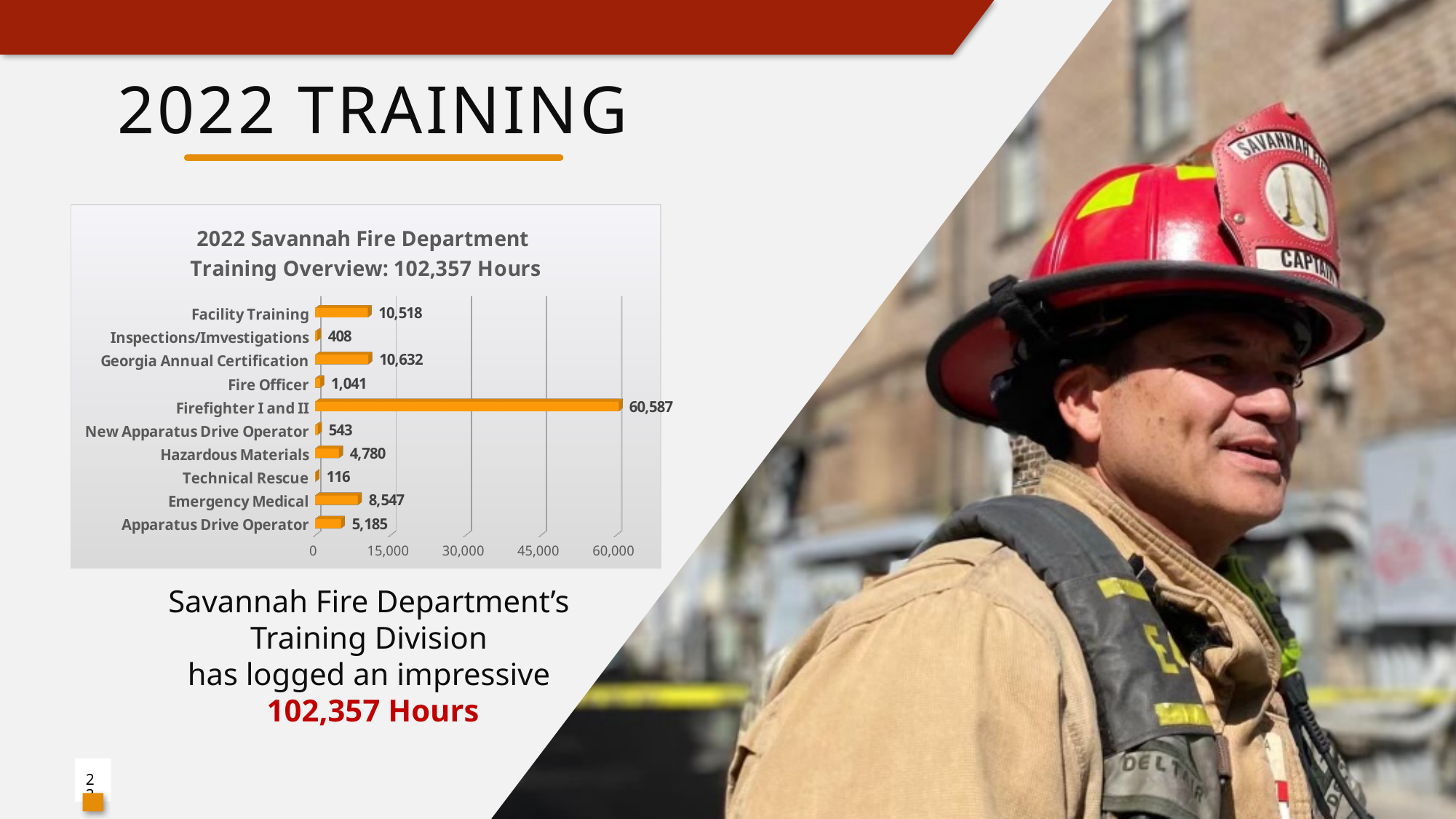
What is the value for Hazardous Materials? 4,780 Is the value for Firefighter I and II greater or less than 45,000? greater What is the difference between Georgia Annual Certification and Facility Training? 114 Which is larger, Emergency Medical or Apparatus Drive Operator? Emergency Medical How many hours are shown for Firefighter I and II? 60,587 What kind of chart is shown on the slide? Bar chart Which category has the lowest number of hours? Technical Rescue How many categories are shown in the chart? 10 Which category has the highest number of hours? Firefighter I and II What is the value for Emergency Medical? 8,547 What is the title of the chart? 2022 Savannah Fire Department Training Overview: 102,357 Hours What is the difference between Fire Officer and New Apparatus Drive Operator? 498